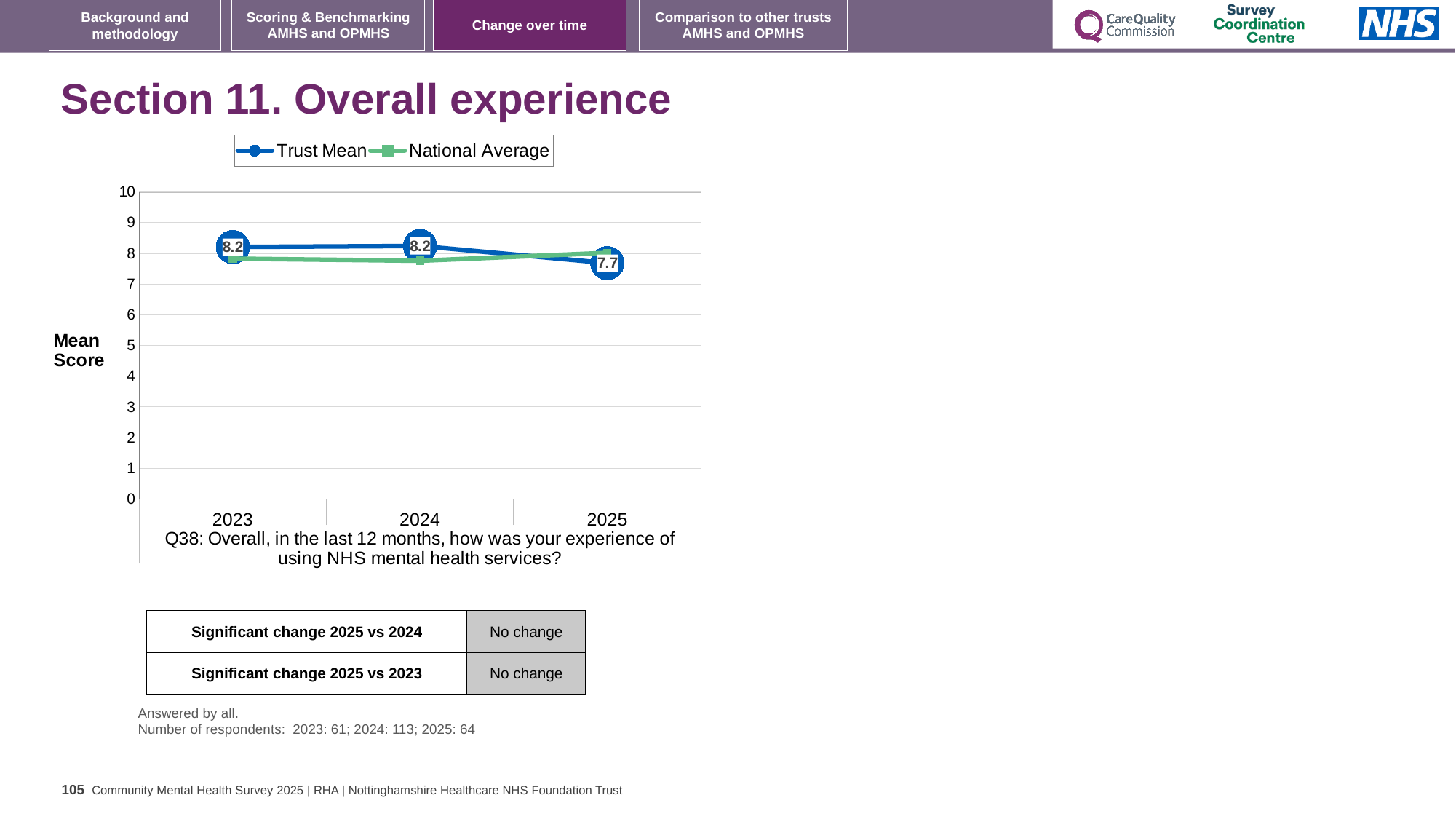
Does the Trust Mean rise or fall from 2024 to 2025? Fall Is the National Average value for 2023 greater or less than 7? greater What kind of chart is shown on the slide? Line chart In which year is the Trust Mean lowest? 2025 Which is larger, the Trust Mean in 2023 or the Trust Mean in 2025? 2023 What is the Trust Mean score for 2025? 7.7 What is the difference between the Trust Mean in 2024 and in 2025? 0.5 What is the Trust Mean score for 2023? 8.2 How many series does the legend list? 2 What is the Trust Mean score for 2024? 8.2 In 2025, which series has the higher value, Trust Mean or National Average? National Average How many years are plotted on the x axis? 3